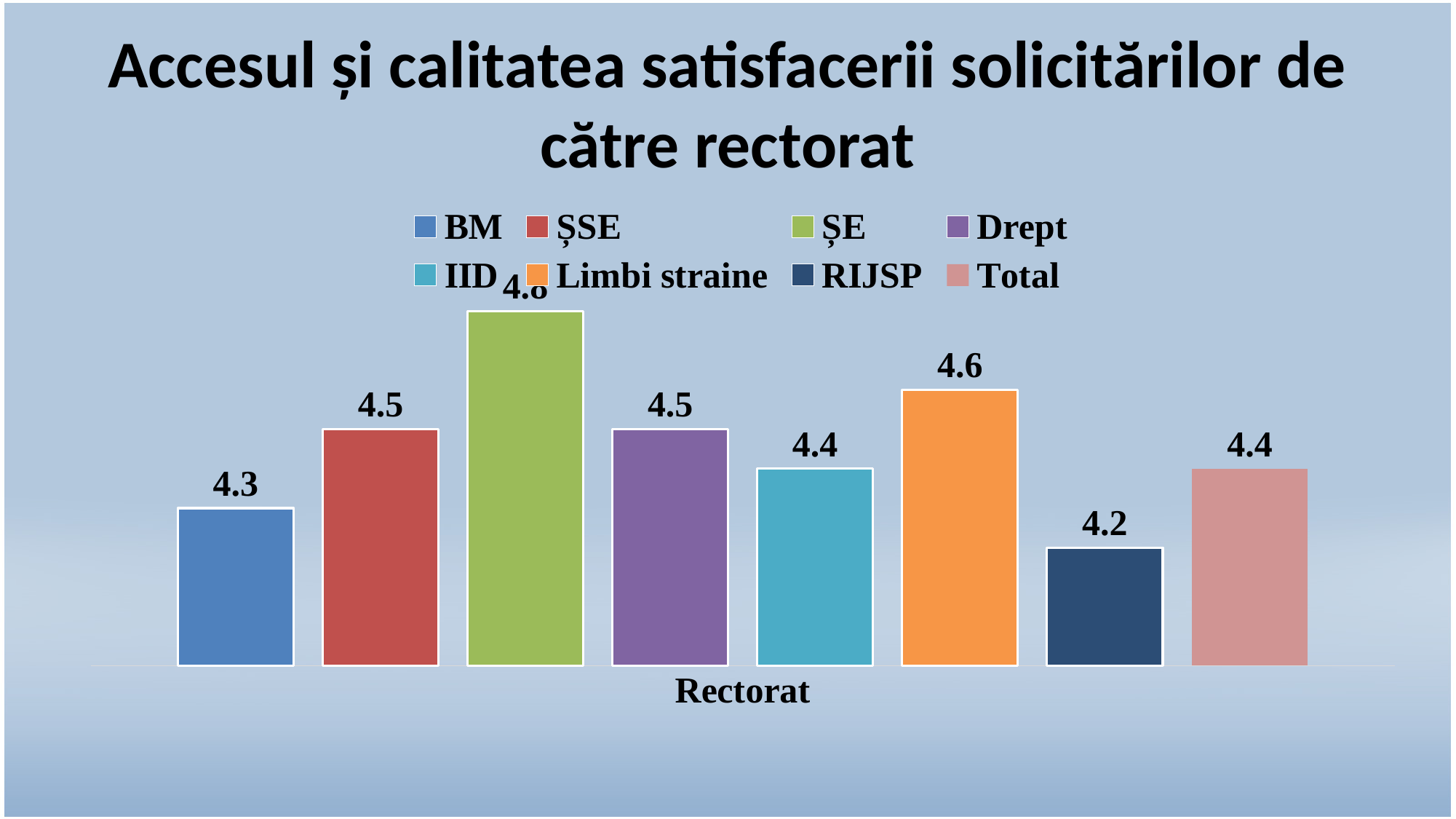
How many series does the legend list? 8 What kind of chart is shown on the slide? Bar chart What is the value for BM? 4.3 What is the value for IID? 4.4 What is the value for RIJSP? 4.2 Which is larger, the value for BM or the value for IID? IID Which series has the highest bar? ȘE What is the value for ȘSE? 4.5 What is the value for Total? 4.4 Which series has the lowest value? RIJSP What is the value for Limbi straine? 4.6 What is the difference between the values for Limbi straine and RIJSP? 0.4